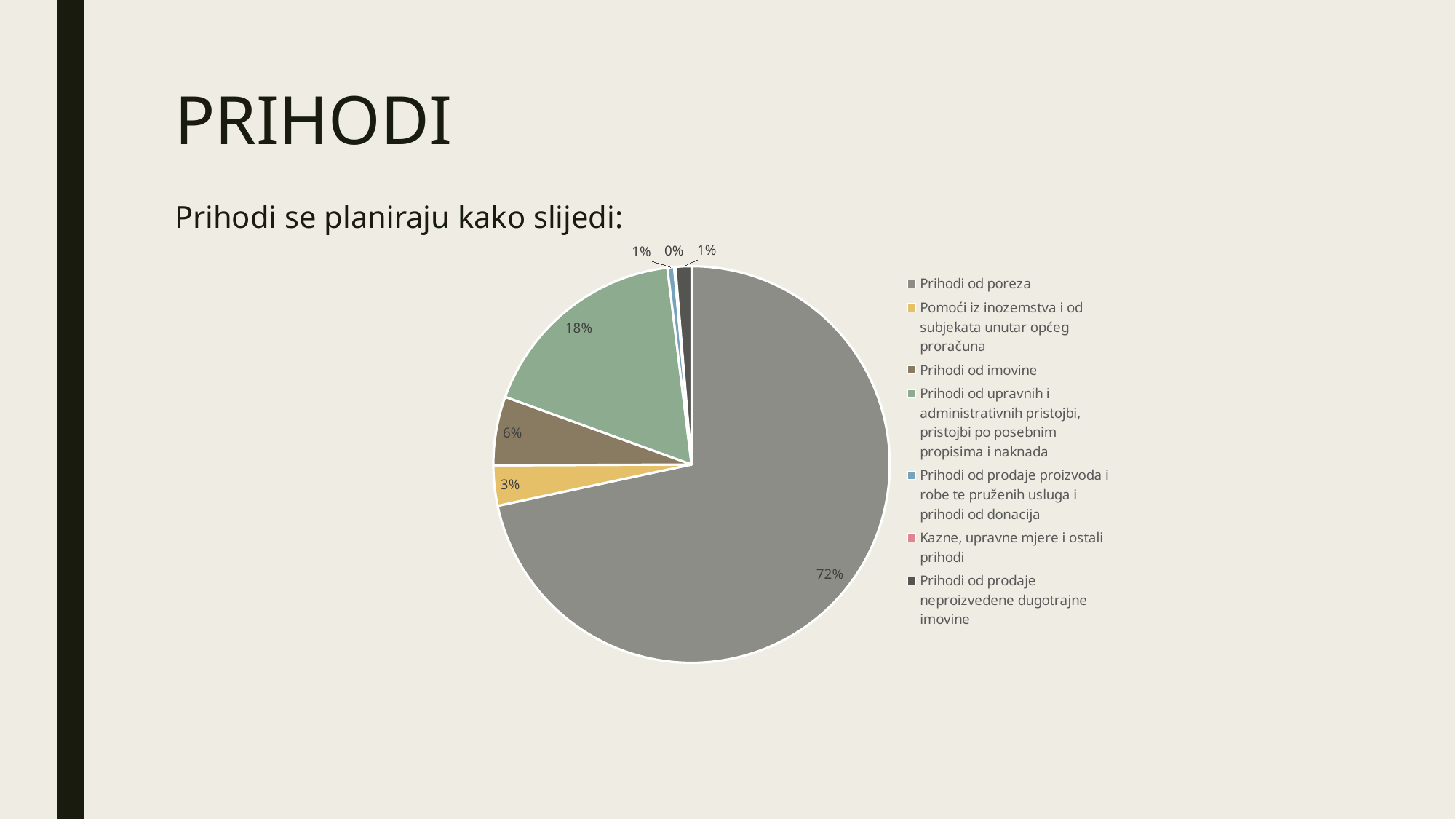
What type of chart is shown on the slide? Pie chart Which category has the largest slice of the pie? Prihodi od poreza What share of the pie does "Prihodi od poreza" represent? 72% Which is larger, the share for "Prihodi od imovine" or the share for "Pomoći iz inozemstva i od subjekata unutar općeg proračuna"? Prihodi od imovine What is the title of the slide containing the chart? PRIHODI What share of the pie does "Prihodi od upravnih i administrativnih pristojbi, pristojbi po posebnim propisima i naknada" represent? 18% How many categories does the legend list? 7 What share of the pie does "Pomoći iz inozemstva i od subjekata unutar općeg proračuna" represent? 3% Which category has the smallest slice of the pie? Kazne, upravne mjere i ostali prihodi What is the difference in percentage points between "Prihodi od poreza" and "Prihodi od upravnih i administrativnih pristojbi, pristojbi po posebnim propisima i naknada"? 54